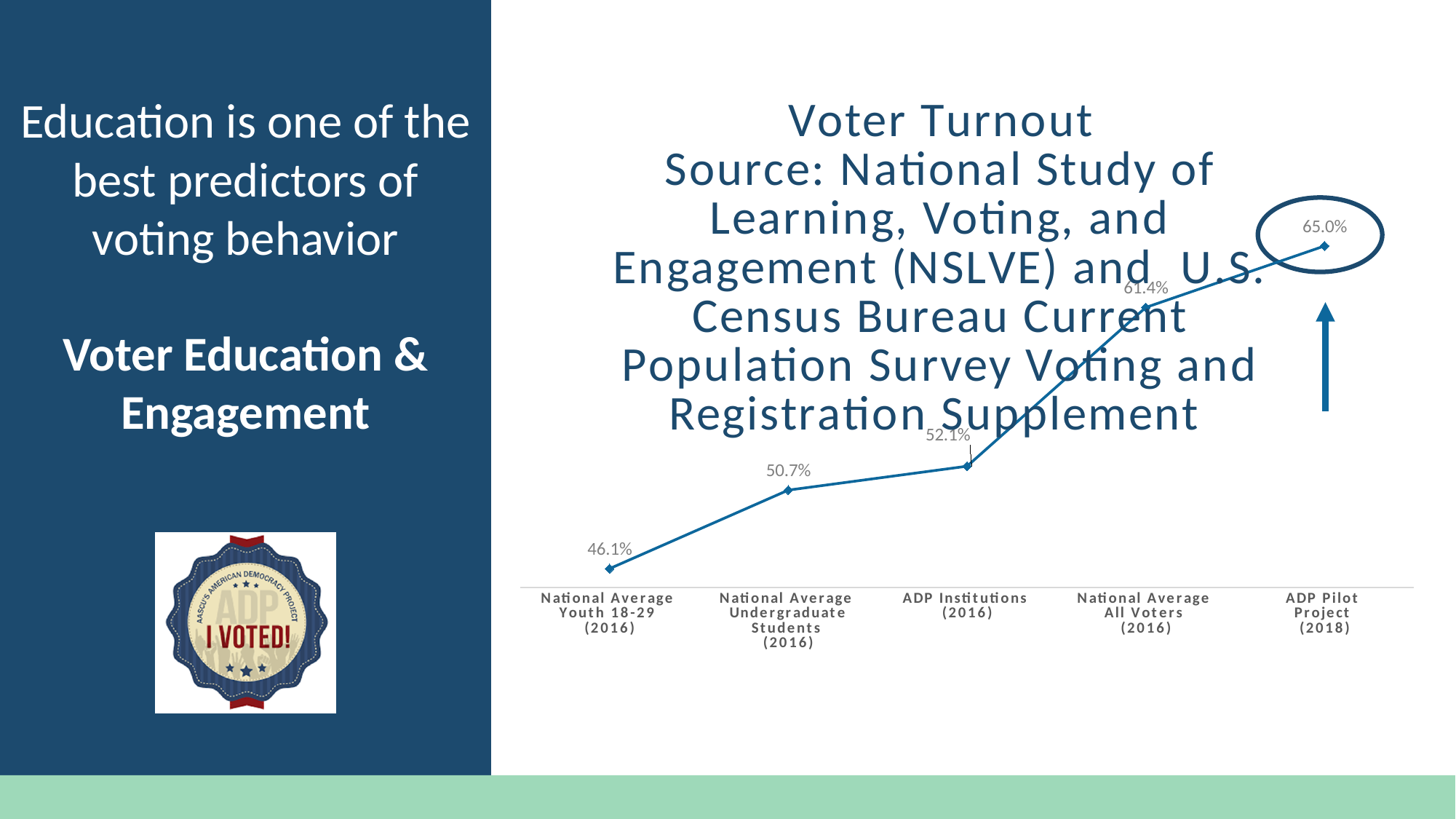
How many categories are plotted on the chart? 5 Which category has the highest voter turnout? ADP Pilot Project (2018) What is the voter turnout value for National Average Undergraduate Students (2016)? 50.7% What kind of chart is shown on the slide? Line chart What is the voter turnout value for ADP Pilot Project (2018)? 65.0% Do the voter turnout values rise or fall from left to right along the x axis? Rise What is the voter turnout value for ADP Institutions (2016)? 52.1% Which category has the lowest voter turnout? National Average Youth 18-29 (2016) What is the difference in voter turnout between ADP Pilot Project (2018) and National Average Youth 18-29 (2016)? 18.9% What is the difference in voter turnout between ADP Institutions (2016) and National Average Undergraduate Students (2016)? 1.4% What is the voter turnout value for National Average Youth 18-29 (2016)? 46.1% Which has a higher voter turnout, National Average All Voters (2016) or ADP Institutions (2016)? National Average All Voters (2016)